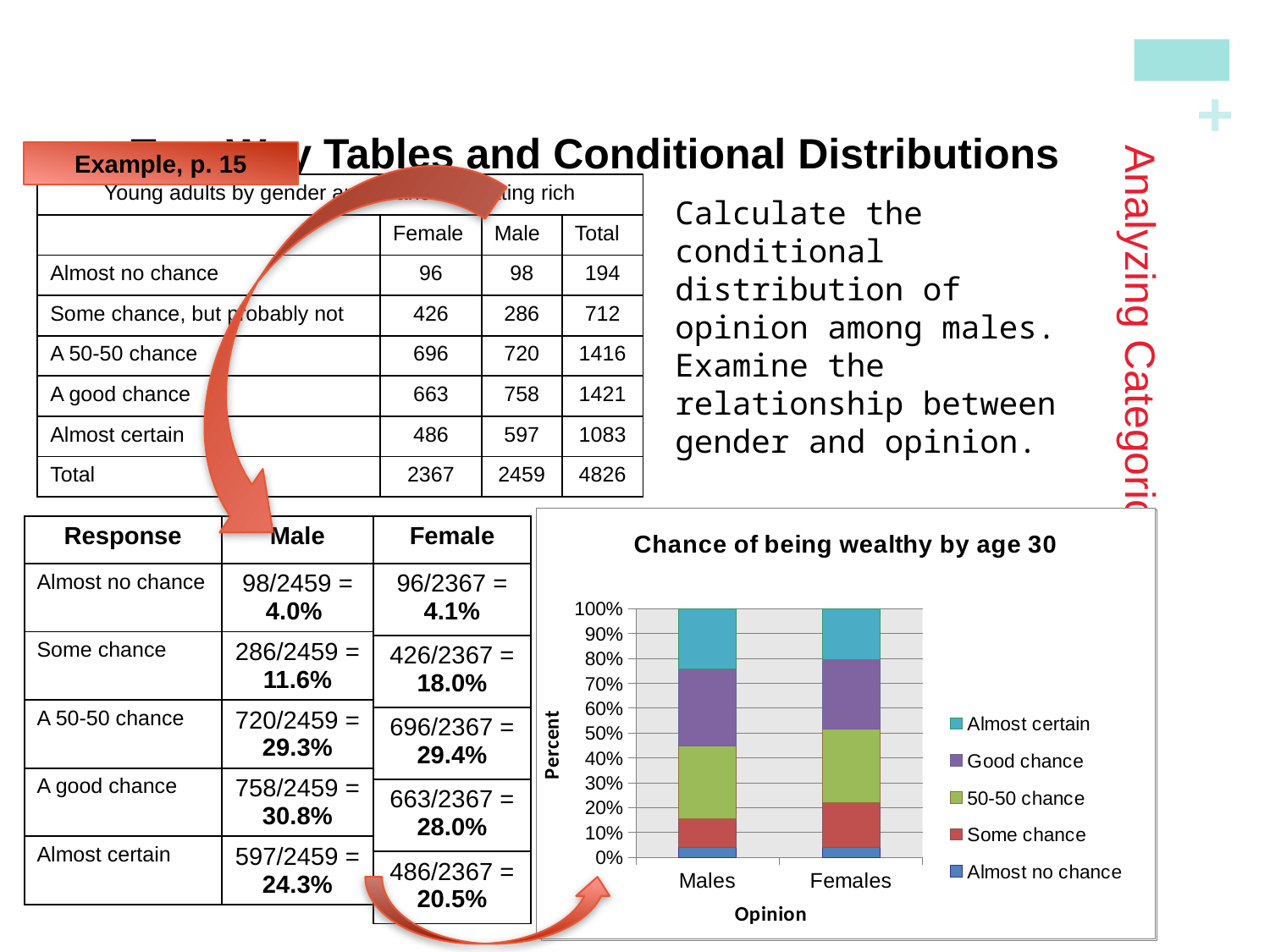
How many bars (categories) are plotted on the x axis of the chart? 2 What is the title of the chart? Chance of being wealthy by age 30 Is the 'Good chance' segment for Males greater or less than 20%? greater Is the '50-50 chance' segment for Females greater or less than 20%? greater What is the label of the vertical axis of the chart? Percent How many series does the chart legend list? 5 Which bar has the larger 'Some chance' segment, Males or Females? Females Is the 'Almost no chance' segment for Males greater or less than 10%? less What type of chart is shown on the slide? stacked bar chart Which bar has the larger 'Almost certain' segment, Males or Females? Males What does each stacked bar in the chart total? 100%